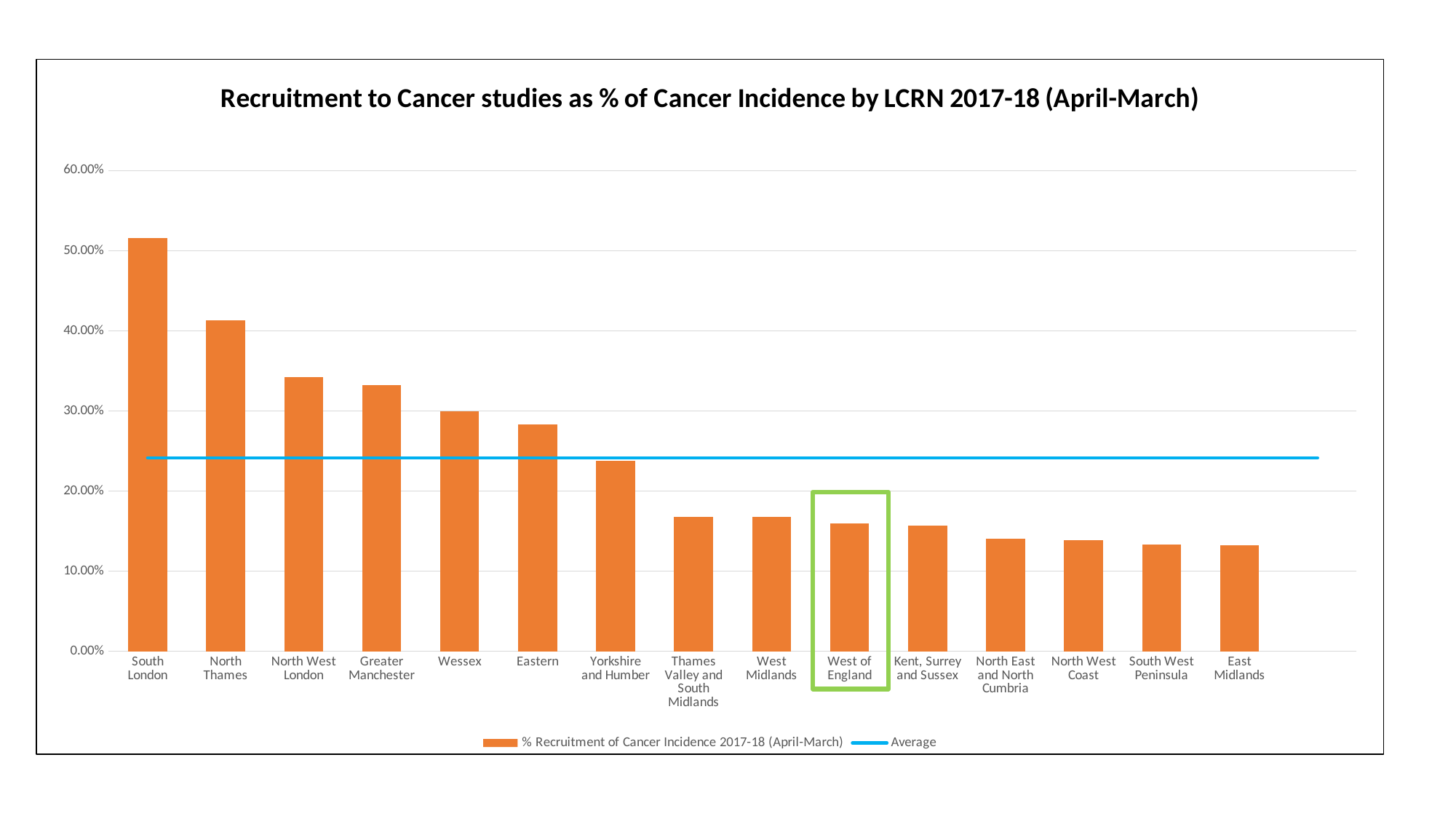
Is the value for North Thames greater or less than 40.00%? greater What kind of chart is shown on the slide? Bar chart Is the value for South London greater or less than 50.00%? greater Do the bar values rise or fall moving from left to right along the x axis? Fall How many LCRNs (categories) are plotted on the x axis? 15 What does the blue horizontal line on the chart represent, according to the legend? Average Is the value for West of England greater or less than 20.00%? less How many series does the legend list? 2 Which is larger, the value for Wessex or the value for Eastern? Wessex Which LCRN has the highest recruitment as % of cancer incidence? South London